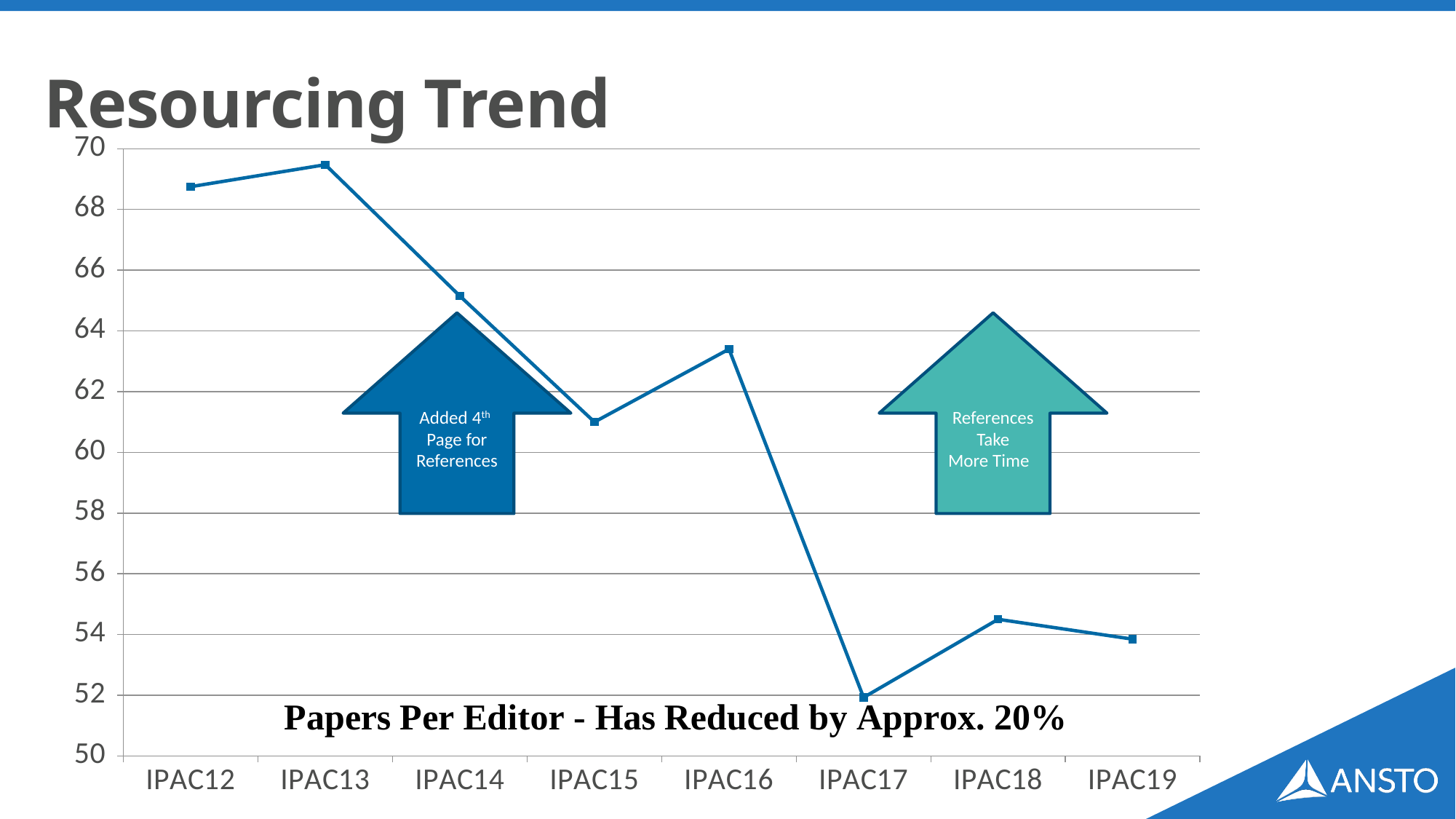
Which conference has the lowest value on the chart? IPAC17 Is the value for IPAC15 greater or less than 62? less Is the value for IPAC17 greater or less than 54? less How many conferences (data points) are plotted along the x axis? 8 Overall, do the values rise or fall from IPAC12 to IPAC19? fall Which conference has the highest value on the chart? IPAC13 What kind of chart is shown on the slide? line chart Is the value for IPAC19 greater or less than 56? less What is the title of the slide containing the chart? Resourcing Trend Which is larger, the value for IPAC16 or the value for IPAC15? IPAC16